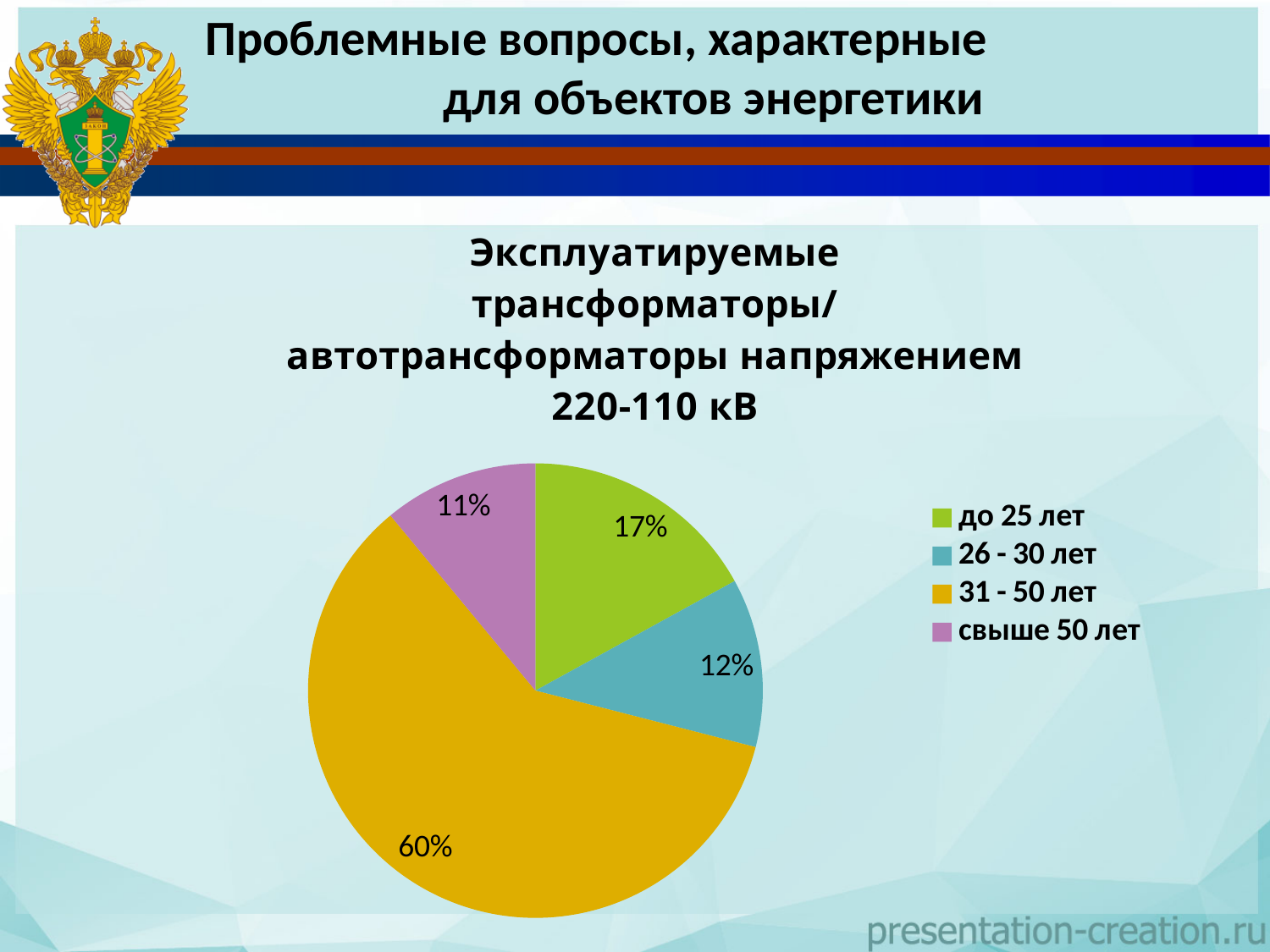
What colour is the "31 - 50 лет" slice? yellow What is the difference in percentage points between the "31 - 50 лет" slice and the "до 25 лет" slice? 43 What share of the pie does the "26 - 30 лет" slice have? 12% Which category has the largest slice of the pie? 31 - 50 лет How many categories does the pie chart have? 4 What kind of chart is shown on the slide? pie chart What share of the pie does the "свыше 50 лет" slice have? 11% What is the title of the chart? Эксплуатируемые трансформаторы/автотрансформаторы напряжением 220-110 кВ Which category has the smallest slice of the pie? свыше 50 лет What share of the pie does the "до 25 лет" slice have? 17% Which slice is larger: "до 25 лет" or "26 - 30 лет"? до 25 лет